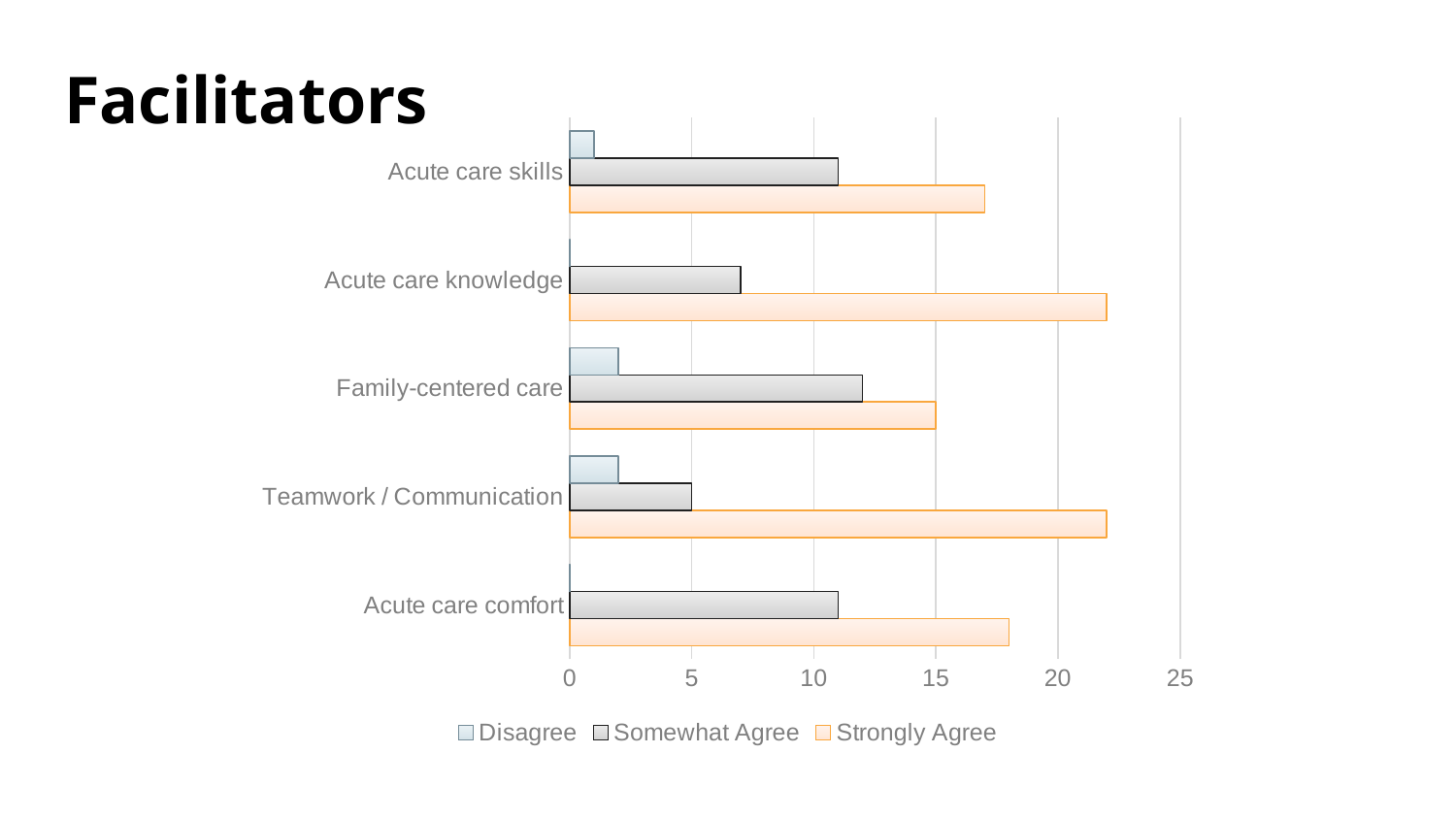
What is the Strongly Agree value for Family-centered care? 15 Is the Somewhat Agree value for Acute care knowledge greater or less than 10? less What are the three series named in the legend? Disagree, Somewhat Agree, Strongly Agree Which category has the lowest Somewhat Agree value? Teamwork / Communication What is the Somewhat Agree value for Teamwork / Communication? 5 How many series does the legend list? 3 Which is larger, the Somewhat Agree value for Acute care skills or for Acute care knowledge? Acute care skills Is the Strongly Agree value for Acute care skills greater or less than 15? greater Is the Strongly Agree value for Acute care knowledge greater or less than 20? greater What kind of chart is shown on the slide? bar chart What is the title shown above the chart? Facilitators How many categories are plotted on the chart? 5